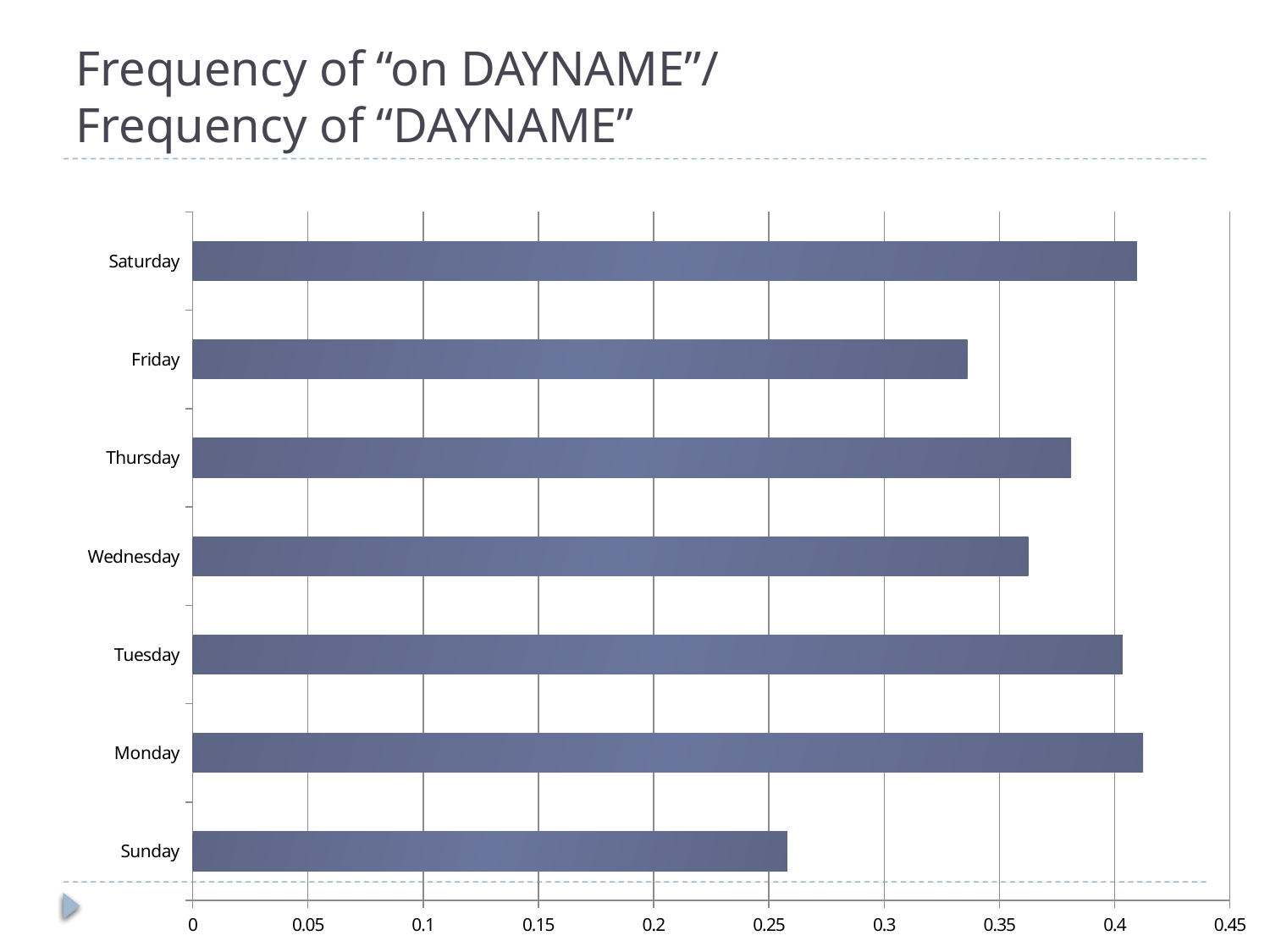
Which day has the lowest value in the chart? Sunday Is the value for Thursday greater or less than 0.4? less Is the value for Sunday greater or less than 0.3? less What is the highest value shown on the horizontal axis of the chart? 0.45 Is the value for Wednesday greater or less than 0.35? greater What kind of chart is shown on the slide? bar chart How many days are plotted in the chart? 7 Which has the larger value, Sunday or Friday? Friday Which has the larger value, Thursday or Friday? Thursday